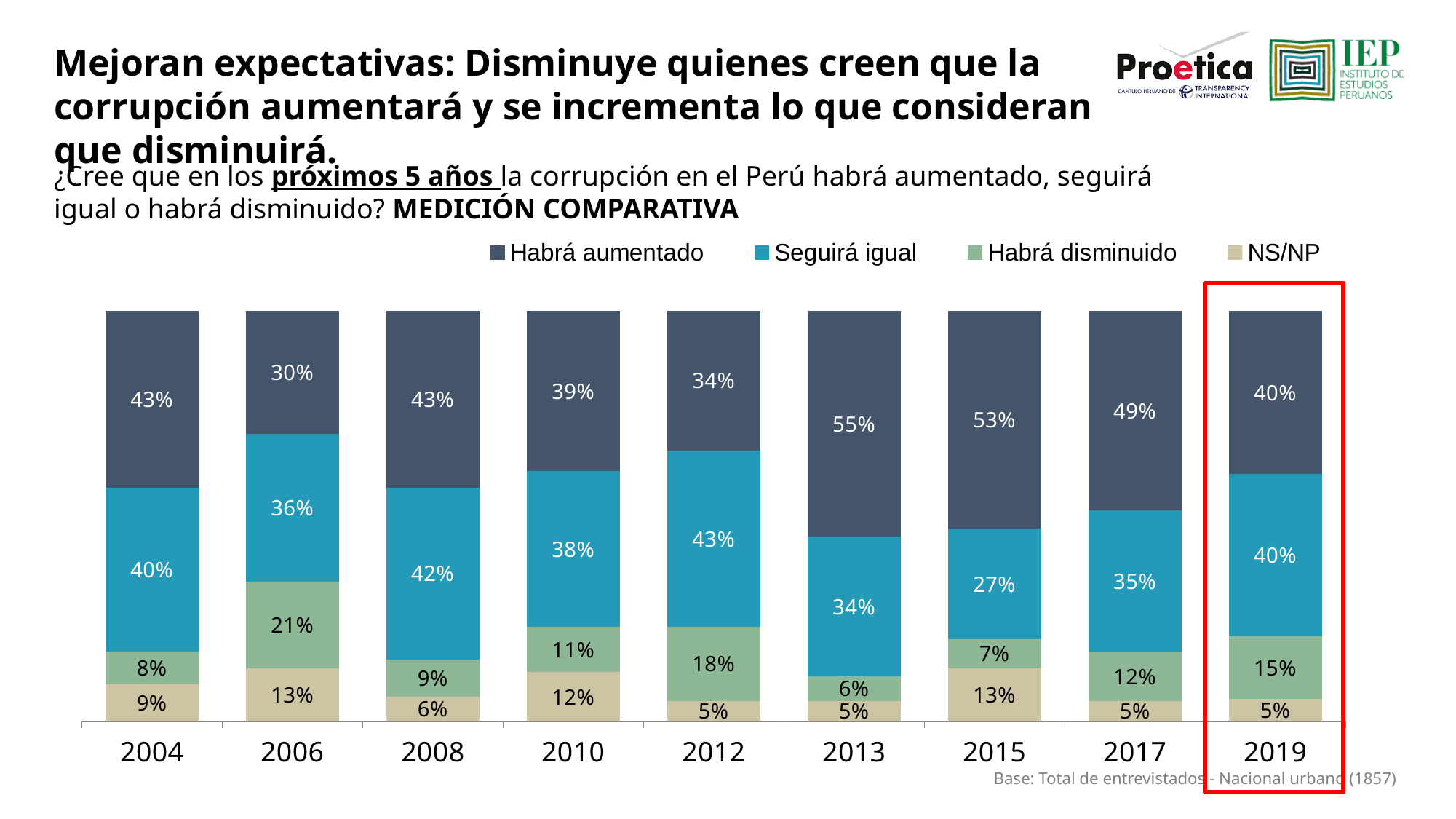
Which is larger, the "Seguirá igual" value in 2015 or in 2017? 2017 What is the value for "Seguirá igual" in 2012? 43% What is the difference between the "Habrá aumentado" values for 2017 and 2019? 9% In which year is the value for "Habrá disminuido" lowest? 2013 How many years are shown along the x axis? 9 What is the value for "Habrá disminuido" in 2006? 21% What is the value for "Habrá aumentado" in 2019? 40% How many series does the legend list? 4 What kind of chart is shown on the slide? Stacked bar chart In which year is the value for "Habrá aumentado" highest? 2013 Which legend entry is shown in the lightest (beige) colour? NS/NP What is the value for "NS/NP" in 2015? 13%